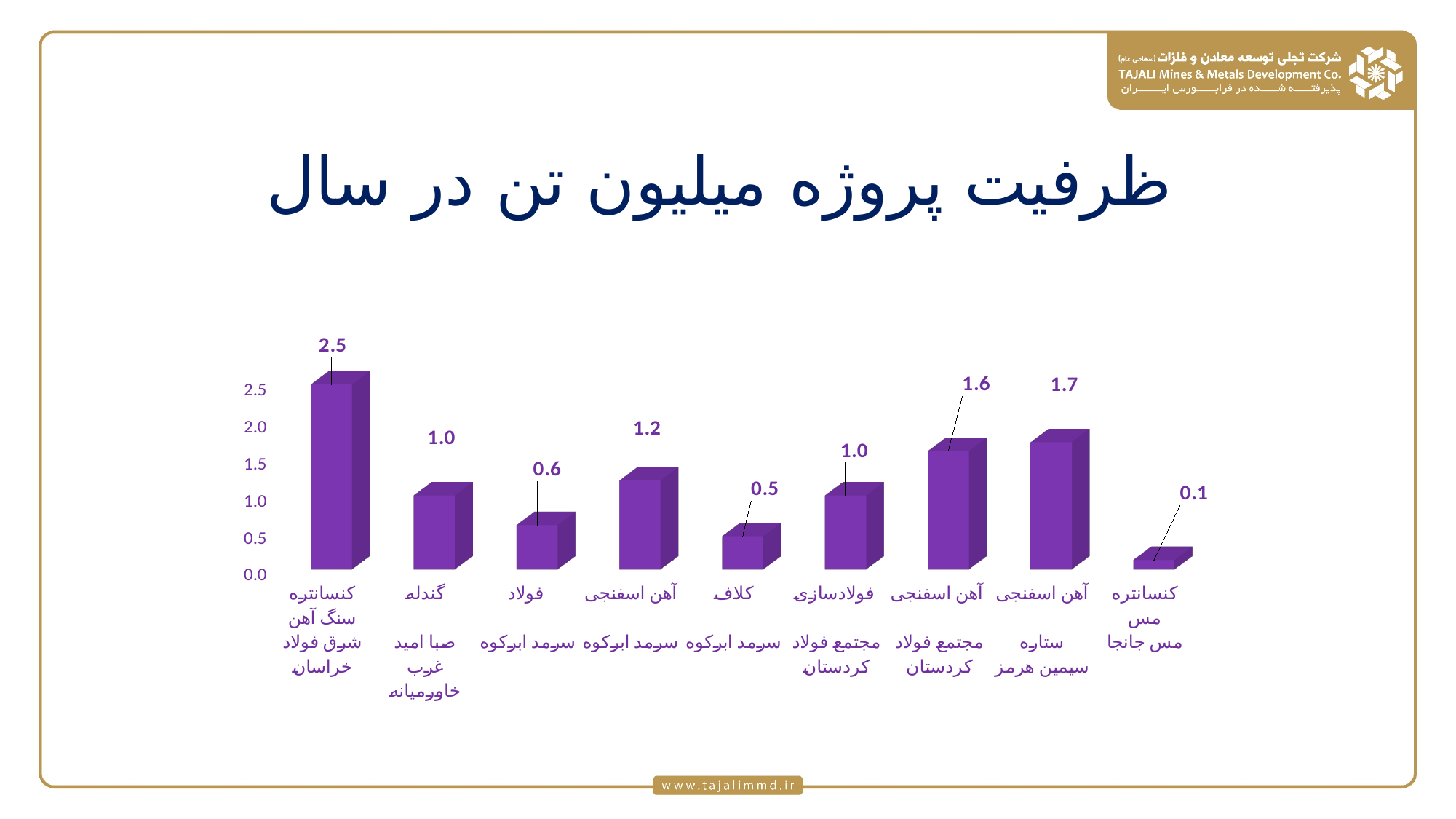
What is the value for آهن اسفنجی ستاره سیمین هرمز? 1.7 What is the value for گندله صبا امید غرب خاورمیانه? 1.0 How many categories are shown in the chart? 9 What kind of chart is shown on the slide? bar chart What is the value for کلاف سرمد ابرکوه? 0.5 What is the difference between the values for آهن اسفنجی ستاره سیمین هرمز and آهن اسفنجی مجتمع فولاد کردستان? 0.1 Which is larger, the value for آهن اسفنجی سرمد ابرکوه or the value for فولاد سرمد ابرکوه? آهن اسفنجی سرمد ابرکوه Is the value for آهن اسفنجی مجتمع فولاد کردستان greater or less than 1.5? greater What is the value for کنسانتره سنگ آهن شرق فولاد خراسان? 2.5 Which category has the lowest value? کنسانتره مس مس جانجا What is the title of the chart? ظرفیت پروژه میلیون تن در سال Which category has the highest value? کنسانتره سنگ آهن شرق فولاد خراسان